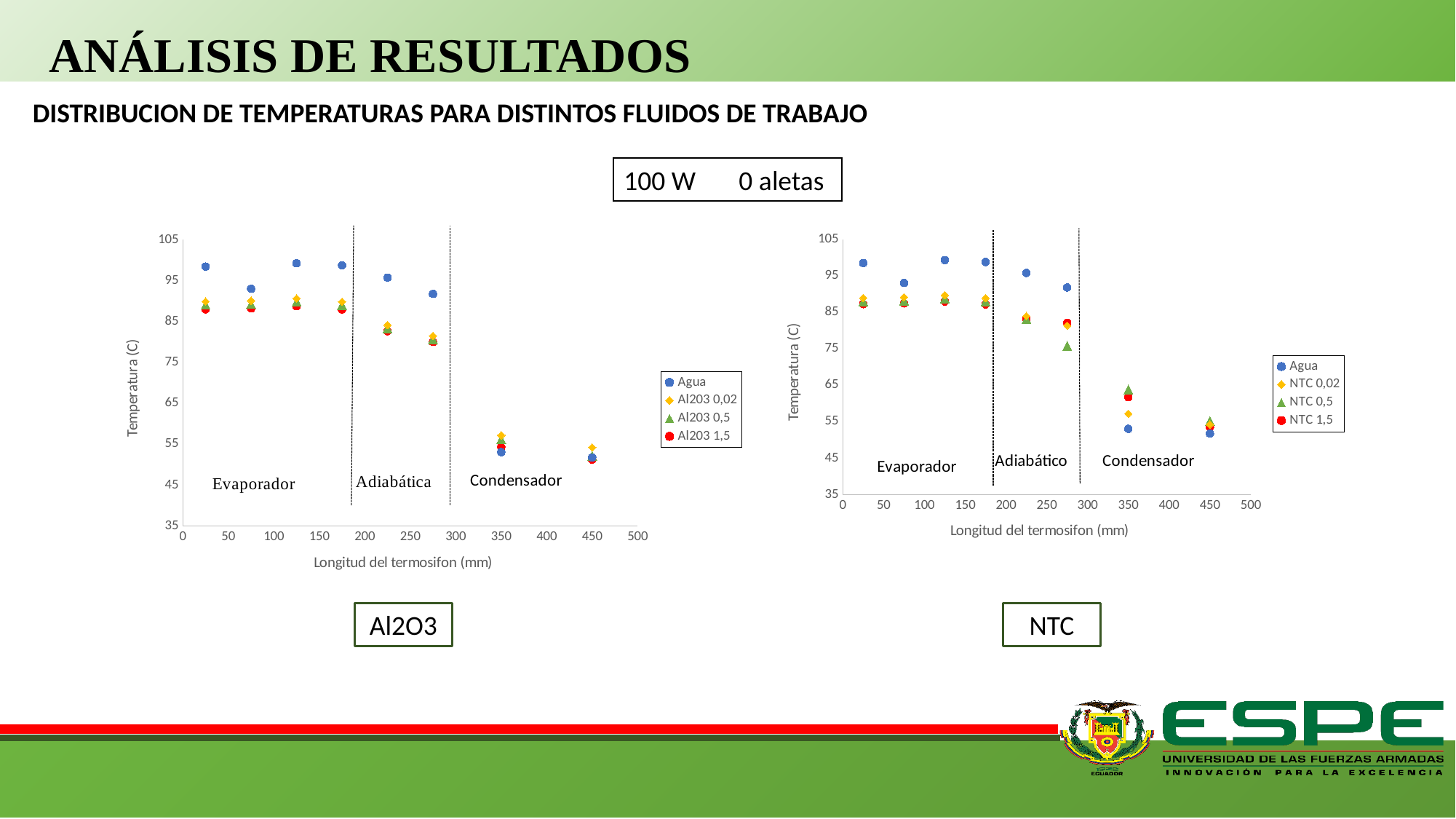
What is the x-axis title of the right chart (NTC)? Longitud del termosifon (mm) In the left chart (Al2O3), is the value for Agua at 125 mm greater or less than 95? greater What kind of chart is the left chart labelled Al2O3? scatter chart In the right chart (NTC), does the Agua series rise or fall overall along the x axis? fall How many x positions (points per series) are plotted in the left chart (Al2O3)? 8 How many series does the legend of the left chart (Al2O3) list? 4 In the left chart (Al2O3), at 25 mm, which is larger: Agua or Al2O3 1,5? Agua How many series does the legend of the right chart (NTC) list? 4 In the left chart (Al2O3), is the value for Agua at 450 mm greater or less than 55? less In the right chart (NTC), is the value for NTC 0,5 at 275 mm greater or less than 85? less In the right chart (NTC), at 350 mm, which is larger: NTC 0,5 or Agua? NTC 0,5